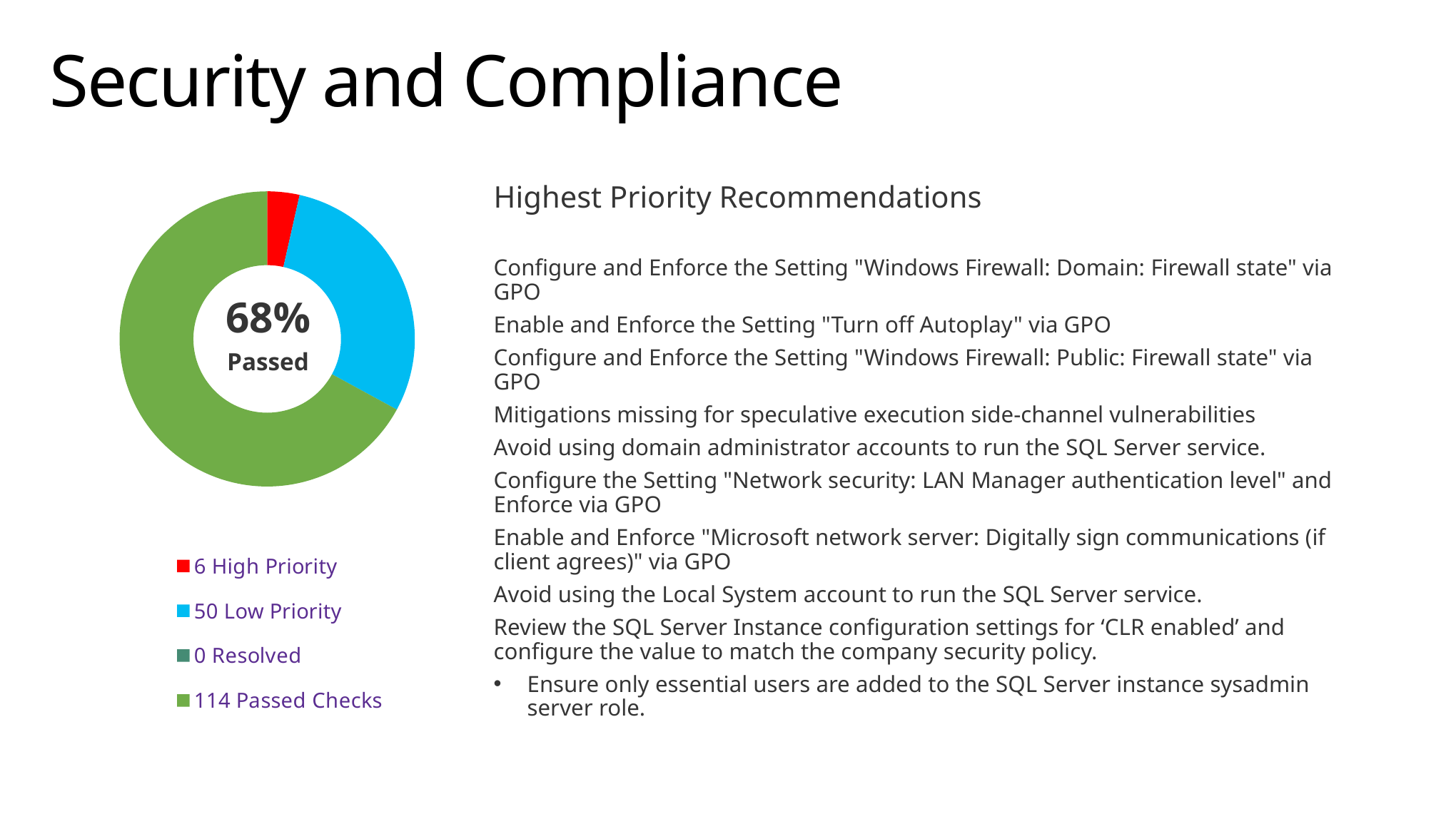
What is the difference between the Low Priority and High Priority counts? 44 Which category has the lowest value? Resolved Which category has the highest value? Passed Checks What percentage is shown in the centre of the chart as Passed? 68% What kind of chart is shown on the slide? pie chart (donut) What is the difference between the Passed Checks and Low Priority counts? 64 How many High Priority items does the legend show? 6 How many Passed Checks does the legend show? 114 How many categories does the legend list? 4 Which is larger, the Low Priority count or the High Priority count? Low Priority How many Low Priority items does the legend show? 50 How many Resolved items does the legend show? 0